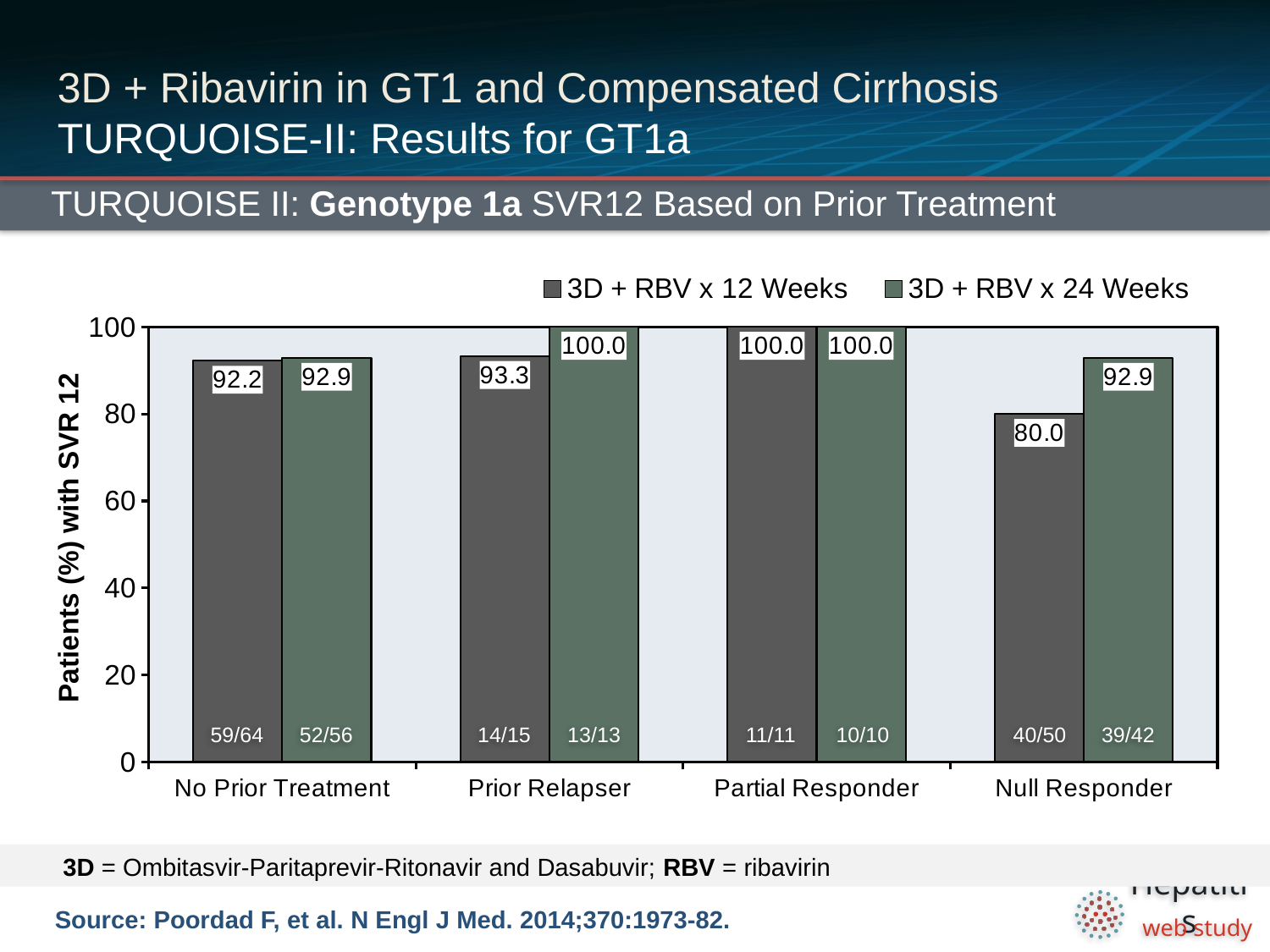
How many prior treatment categories are shown on the x axis? 4 What is the SVR12 rate for the 3D + RBV x 12 Weeks group among patients with No Prior Treatment? 92.2 For Prior Relapsers, which group has the higher SVR12 rate: 3D + RBV x 12 Weeks or 3D + RBV x 24 Weeks? 3D + RBV x 24 Weeks What is the difference between the 3D + RBV x 24 Weeks and 3D + RBV x 12 Weeks SVR12 rates for Null Responders? 12.9 Which prior treatment category has the lowest SVR12 rate for the 3D + RBV x 12 Weeks group? Null Responder How many series does the legend list? 2 What fraction of patients is shown for the 3D + RBV x 12 Weeks group in the Prior Relapser category? 14/15 What kind of chart is shown on the slide? Bar chart Is the SVR12 rate for the 3D + RBV x 12 Weeks group among Null Responders greater or less than 90? less What is the SVR12 rate for the 3D + RBV x 12 Weeks group among Null Responders? 80.0 What is the label of the y axis? Patients (%) with SVR 12 What is the SVR12 rate for the 3D + RBV x 24 Weeks group among Null Responders? 92.9